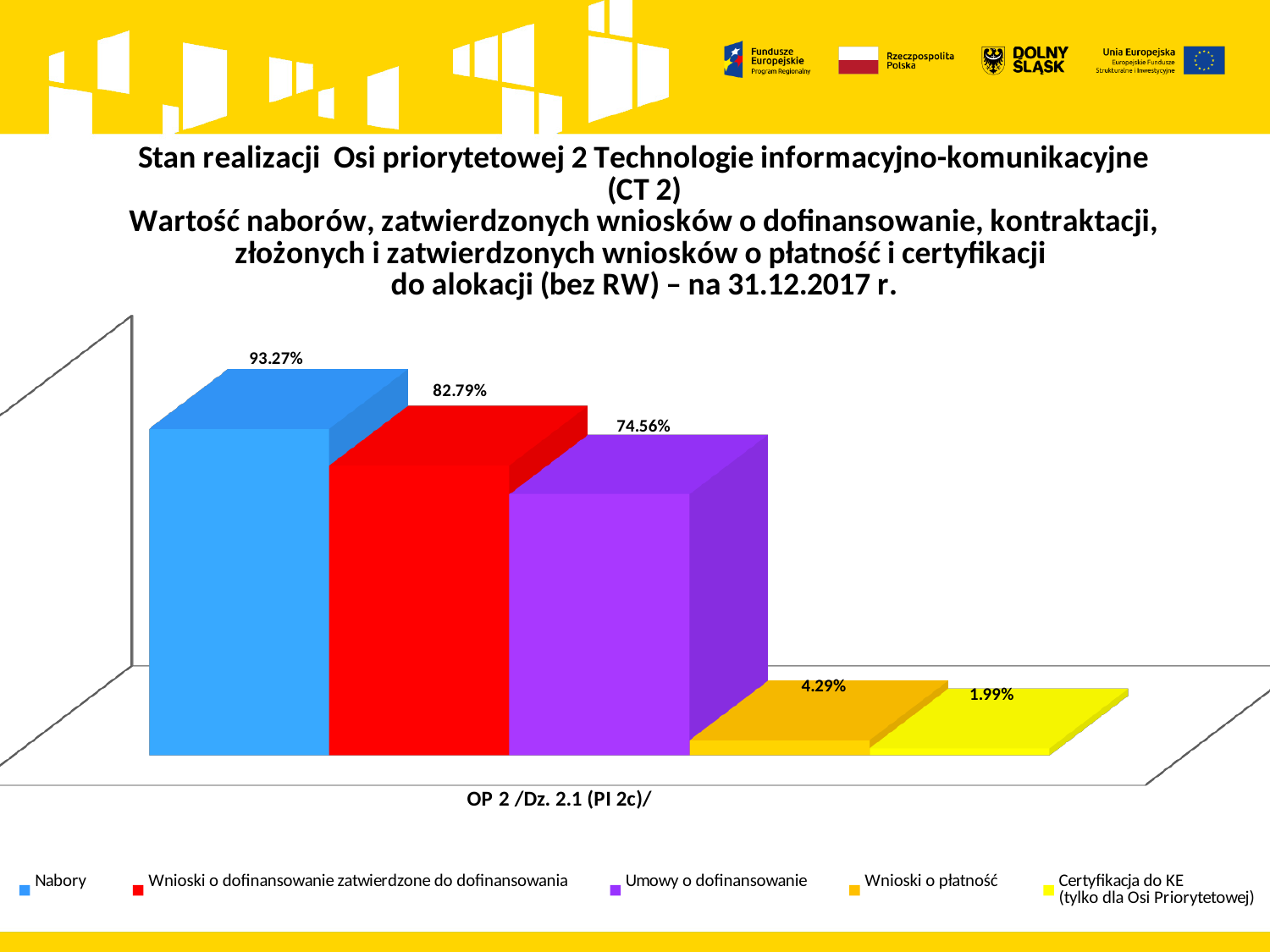
What kind of chart is shown on the slide? Bar chart What is the value for Wnioski o płatność? 4.29% What is the value for Umowy o dofinansowanie? 74.56% What is the value for Nabory? 93.27% Which series has the highest value? Nabory Which series has the lowest value? Certyfikacja do KE (tylko dla Osi Priorytetowej) How many series does the legend list? 5 What is the value for Wnioski o dofinansowanie zatwierdzone do dofinansowania? 82.79% What is the category label shown on the x axis? OP 2 /Dz. 2.1 (PI 2c)/ Which is larger, the value for Wnioski o płatność or the value for Certyfikacja do KE? Wnioski o płatność What is the value for Certyfikacja do KE (tylko dla Osi Priorytetowej)? 1.99% What is the difference between the values for Nabory and Umowy o dofinansowanie? 18.71%